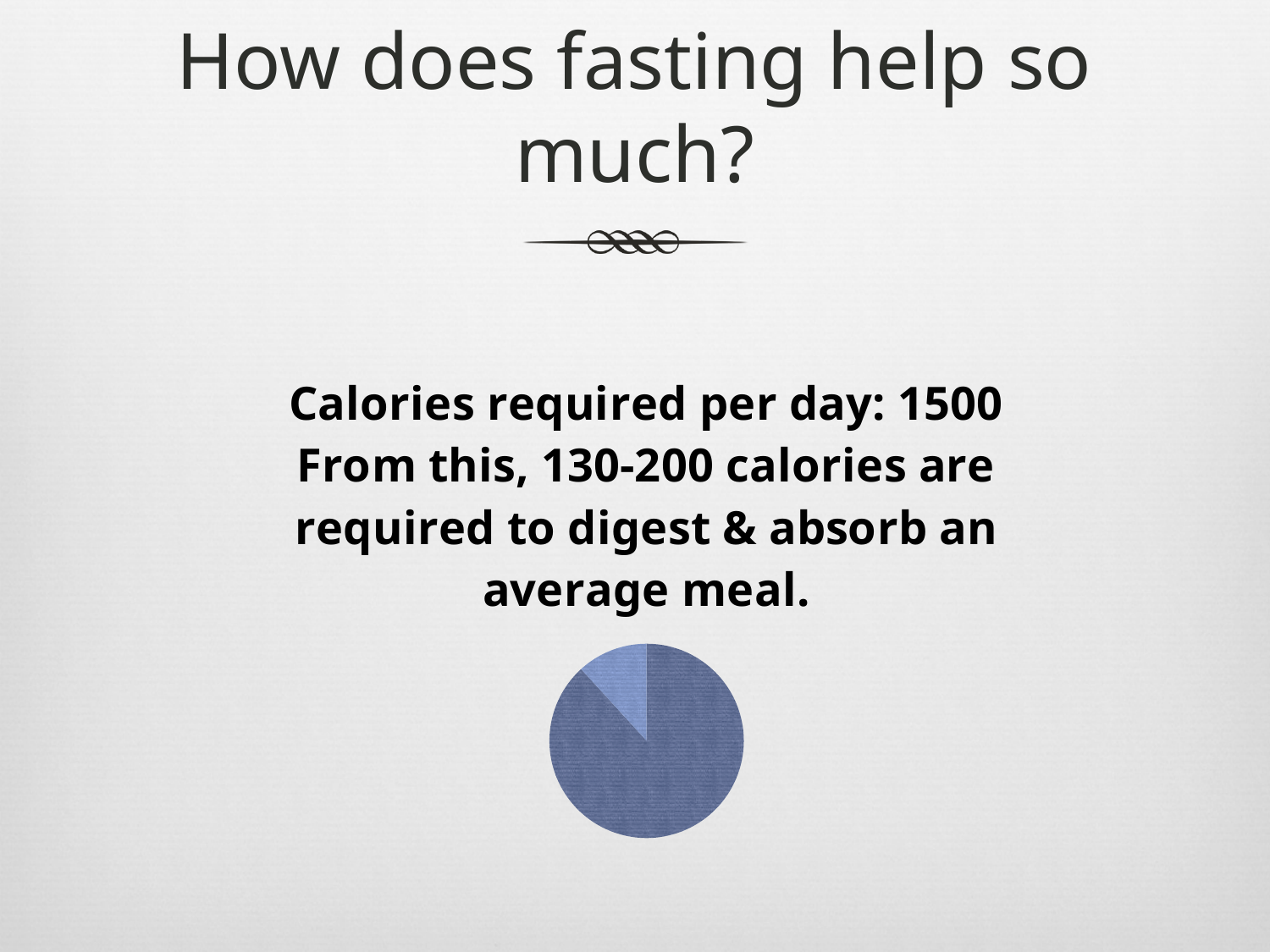
Which slice of the pie chart is larger, the dark blue slice or the light blue slice? the dark blue slice Does the pie chart show any data labels on its slices? No Does the pie chart have a legend? No Which slice of the pie chart is the smallest? the light blue slice What kind of chart is shown on the slide? pie chart How many slices does the pie chart have? 2